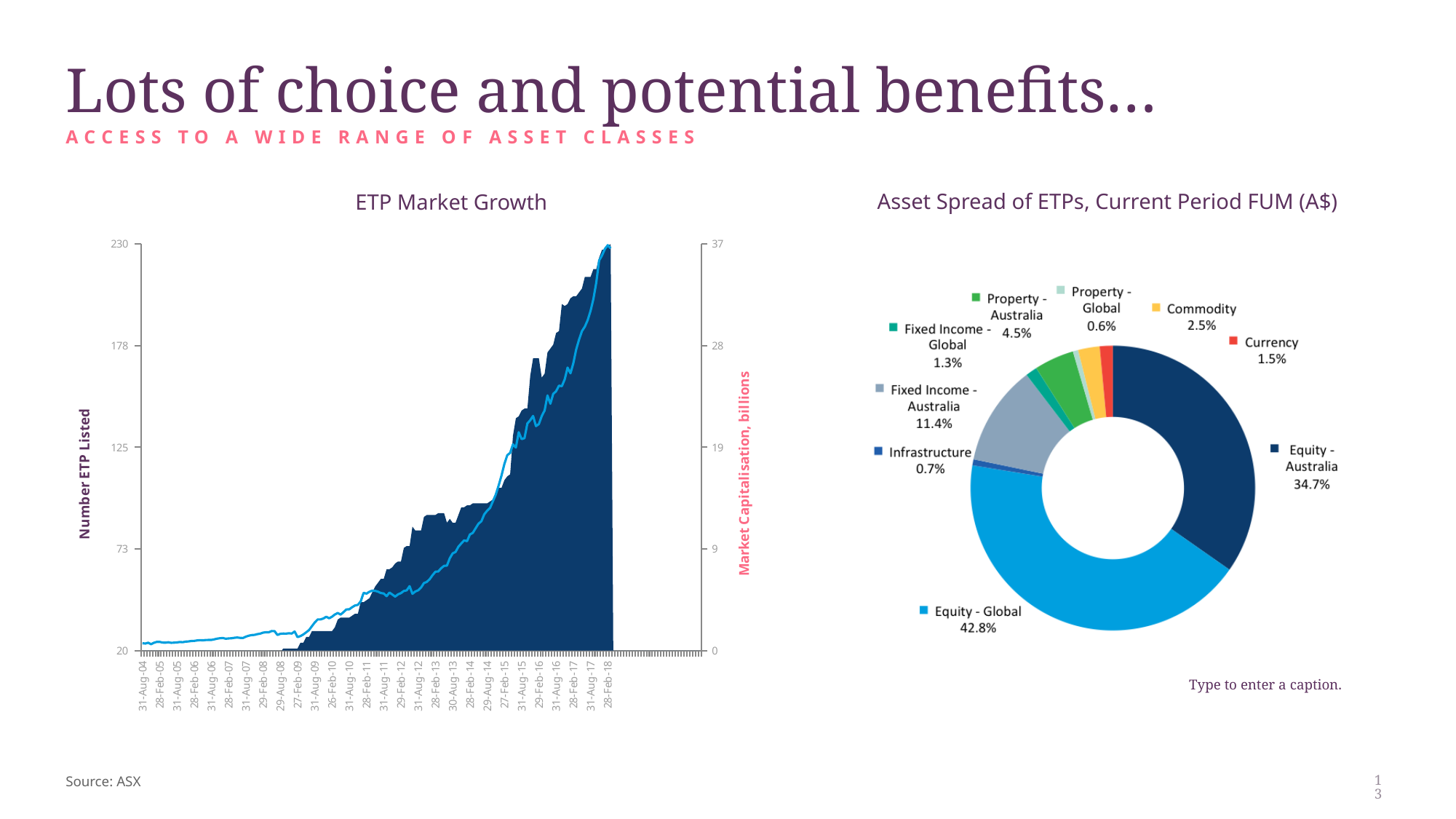
In the ETP Market Growth chart, what is the label of the left vertical axis? Number ETP Listed How many asset classes are shown in the Asset Spread of ETPs chart? 9 In the Asset Spread of ETPs chart, what share does Equity - Global have? 42.8% In the ETP Market Growth chart, what is the label of the right vertical axis? Market Capitalisation, billions In the Asset Spread of ETPs chart, what share does Fixed Income - Australia have? 11.4% In the Asset Spread of ETPs chart, which asset class has the largest share? Equity - Global In the Asset Spread of ETPs chart, what is the difference between the shares of Equity - Global and Equity - Australia? 8.1% In the ETP Market Growth chart, do the values generally rise or fall from 31-Aug-04 to 28-Feb-18? Rise In the Asset Spread of ETPs chart, which asset class has the smallest share? Property - Global In the Asset Spread of ETPs chart, what share does Commodity have? 2.5% What kind of chart is the Asset Spread of ETPs, Current Period FUM (A$) chart? Donut chart In the Asset Spread of ETPs chart, which is larger: Property - Australia or Currency? Property - Australia